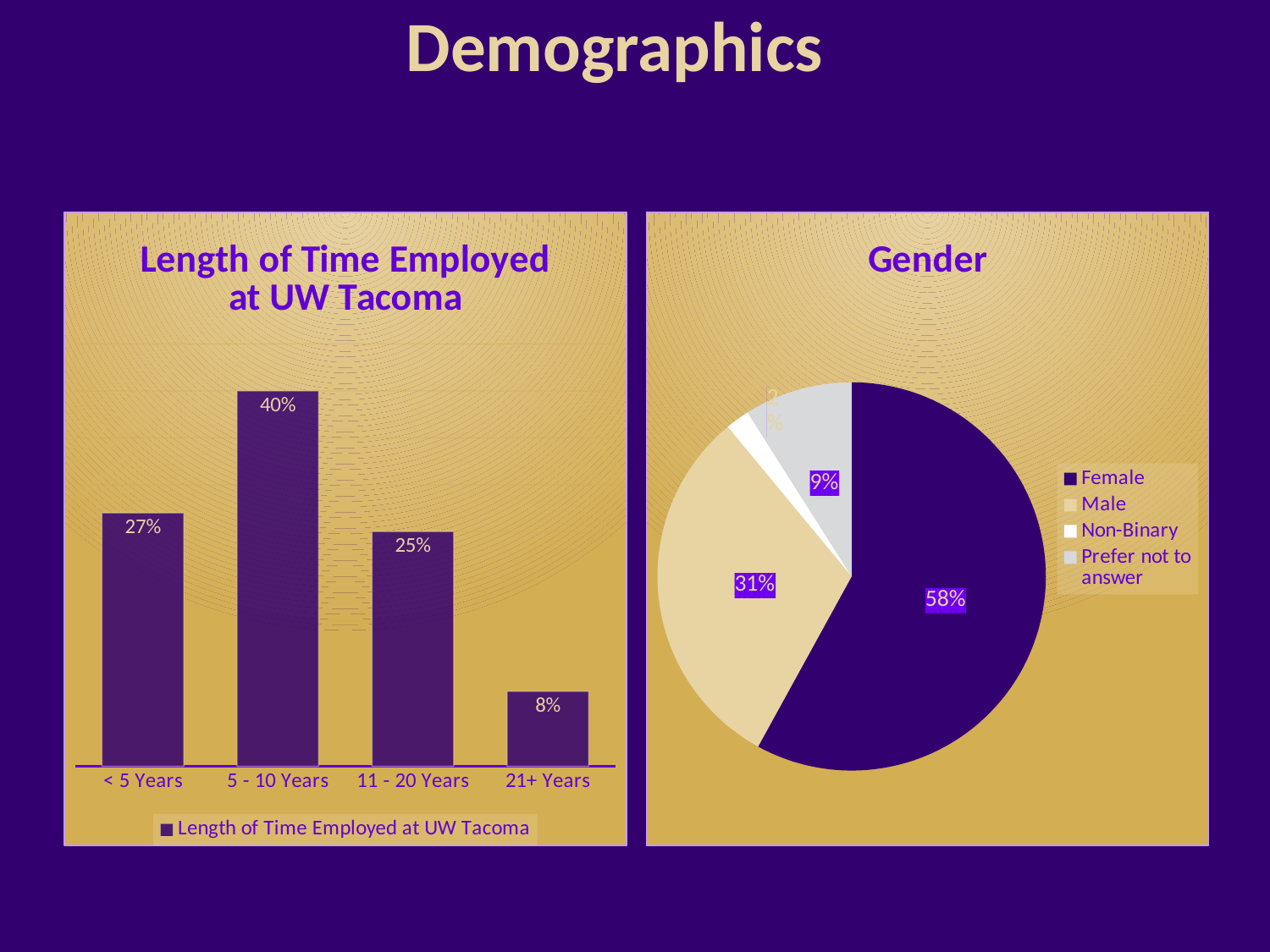
What kind of chart is the 'Length of Time Employed at UW Tacoma' chart? Bar chart In the 'Gender' chart, which is larger: Male or Prefer not to answer? Male In the 'Length of Time Employed at UW Tacoma' chart, what is the value for 5 - 10 Years? 40% In the 'Length of Time Employed at UW Tacoma' chart, how many categories are shown on the x axis? 4 In the 'Gender' chart, what share of the pie is Male? 31% In the 'Gender' chart, what share of the pie is Female? 58% In the 'Length of Time Employed at UW Tacoma' chart, what is the value for 21+ Years? 8% In the 'Gender' chart, which category has the largest slice? Female In the 'Length of Time Employed at UW Tacoma' chart, what is the difference between the values for < 5 Years and 11 - 20 Years? 2% How many entries does the legend of the 'Gender' chart list? 4 In the 'Length of Time Employed at UW Tacoma' chart, which category has the highest value? 5 - 10 Years In the 'Length of Time Employed at UW Tacoma' chart, which category has the lowest value? 21+ Years